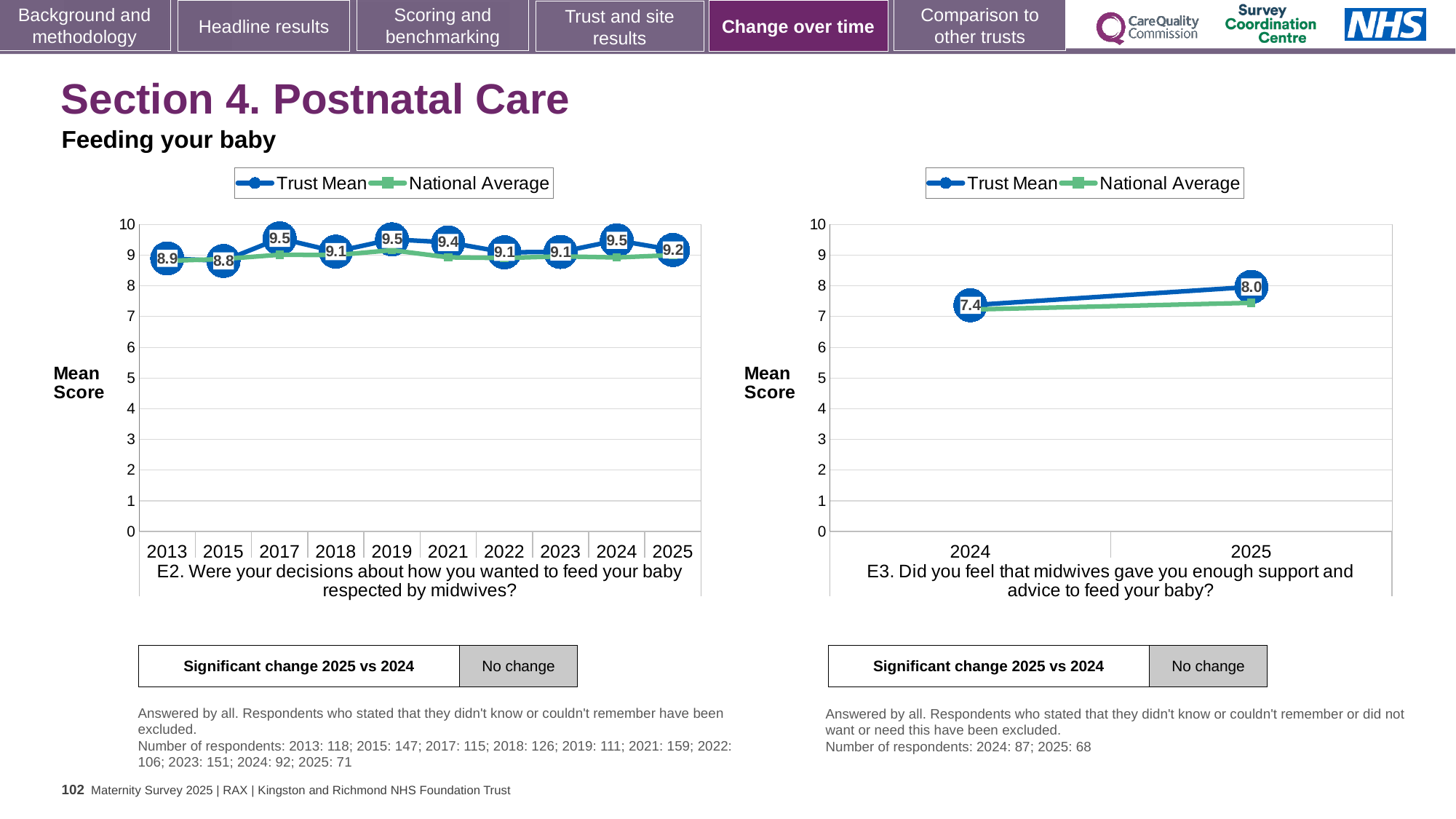
In the E3 chart on the right, is the National Average for 2025 greater or less than 7? greater In the E2 chart on the left, which year has the lowest Trust Mean? 2015 In the E3 chart on the right, what is the Trust Mean for 2025? 8.0 What kind of chart is the E3 chart on the right? Line chart How many years are plotted on the x axis of the E2 chart on the left? 10 In the E2 chart on the left, what is the Trust Mean for 2025? 9.2 How many series does the legend of the E3 chart on the right list? 2 In the E3 chart on the right, what is the difference between the Trust Mean for 2025 and 2024? 0.6 In the E3 chart on the right, does the Trust Mean rise or fall from 2024 to 2025? Rise In the E2 chart on the left, which is larger, the Trust Mean for 2017 or for 2018? 2017 In the E3 chart on the right, what is the Trust Mean for 2024? 7.4 In the E2 chart on the left, what is the Trust Mean for 2013? 8.9